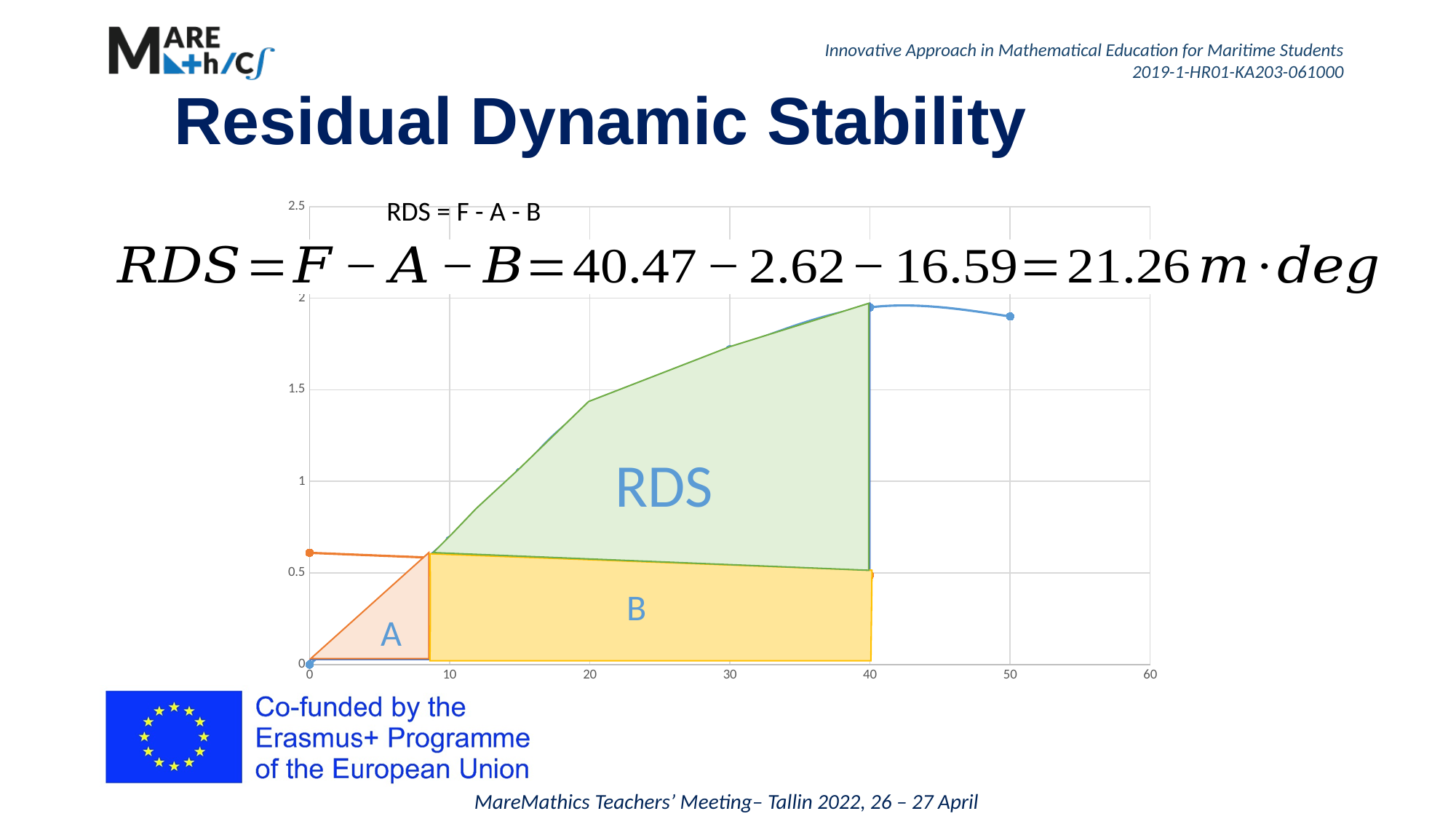
What kind of chart is shown on the slide? line chart What is the difference between the values of B and A given in the formula on the slide? 13.97 According to the formula on the slide, what is the value of area A? 2.62 Is the value of the blue curve at x = 40 greater or less than 1.5? greater Is the value of the orange line at x = 0 greater or less than 0.5? greater According to the formula on the slide, what is the value of RDS? 21.26 m·deg How many labelled shaded regions are there in the chart? 3 Does the blue curve rise or fall between x = 0 and x = 40? rise According to the formula on the slide, what is the value of F? 40.47 According to the formula on the slide, what is the value of area B? 16.59 Is the value of the blue curve at x = 20 greater or less than 1? greater Which of the two shaded areas, A or B, has the larger value according to the formula on the slide? B